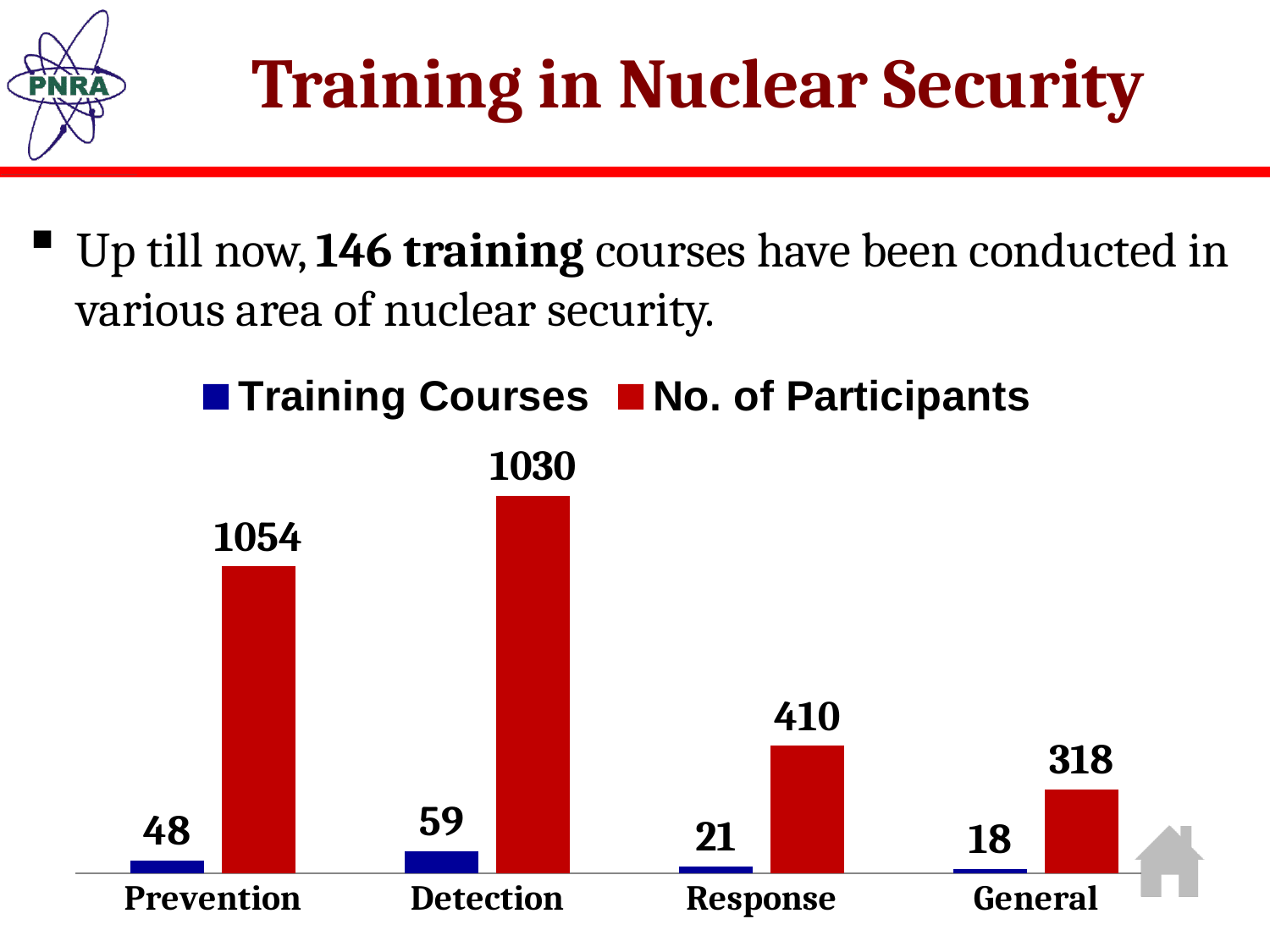
Which category has the highest number of participants? Prevention What is the difference in training courses between Detection and Prevention? 11 Which has more training courses, Response or General? Response What is the number of participants for General? 318 What is the number of participants for Response? 410 How many training courses were conducted in the Detection area? 59 What kind of chart is shown on the slide? Bar chart What is the difference in the number of participants between Prevention and Detection? 24 Which colour represents No. of Participants in the chart? Red Which category has the lowest number of training courses? General How many series does the legend list? 2 How many categories are shown on the x axis? 4